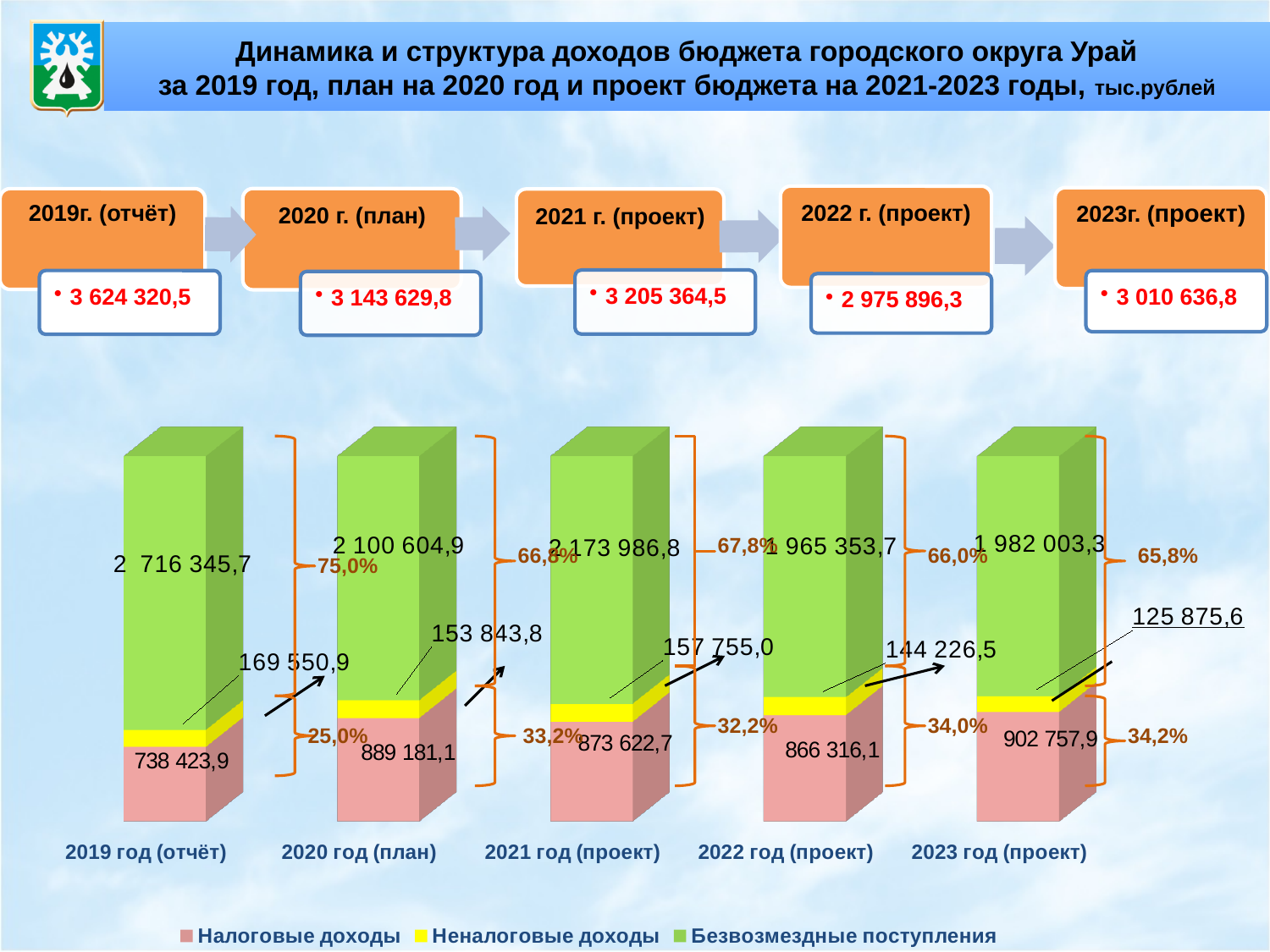
How many years (categories) are shown on the chart? 5 How many series does the legend list? 3 Which is larger: Налоговые доходы in 2020 год (план) or in 2021 год (проект)? 2020 год (план) In which year is Безвозмездные поступления the highest? 2019 год (отчёт) What is the value of Неналоговые доходы for 2023 год (проект)? 125 875,6 What is the value of Налоговые доходы for 2022 год (проект)? 866 316,1 What is the total of the stacked bar for 2019 год (отчёт)? 3 624 320,5 What is the value of Безвозмездные поступления for 2021 год (проект)? 2 173 986,8 What is the value of Налоговые доходы for 2019 год (отчёт)? 738 423,9 What kind of chart is shown on the slide? Stacked bar chart What is the difference between Налоговые доходы in 2023 год (проект) and 2022 год (проект)? 36 441,8 In which year is Неналоговые доходы the lowest? 2023 год (проект)